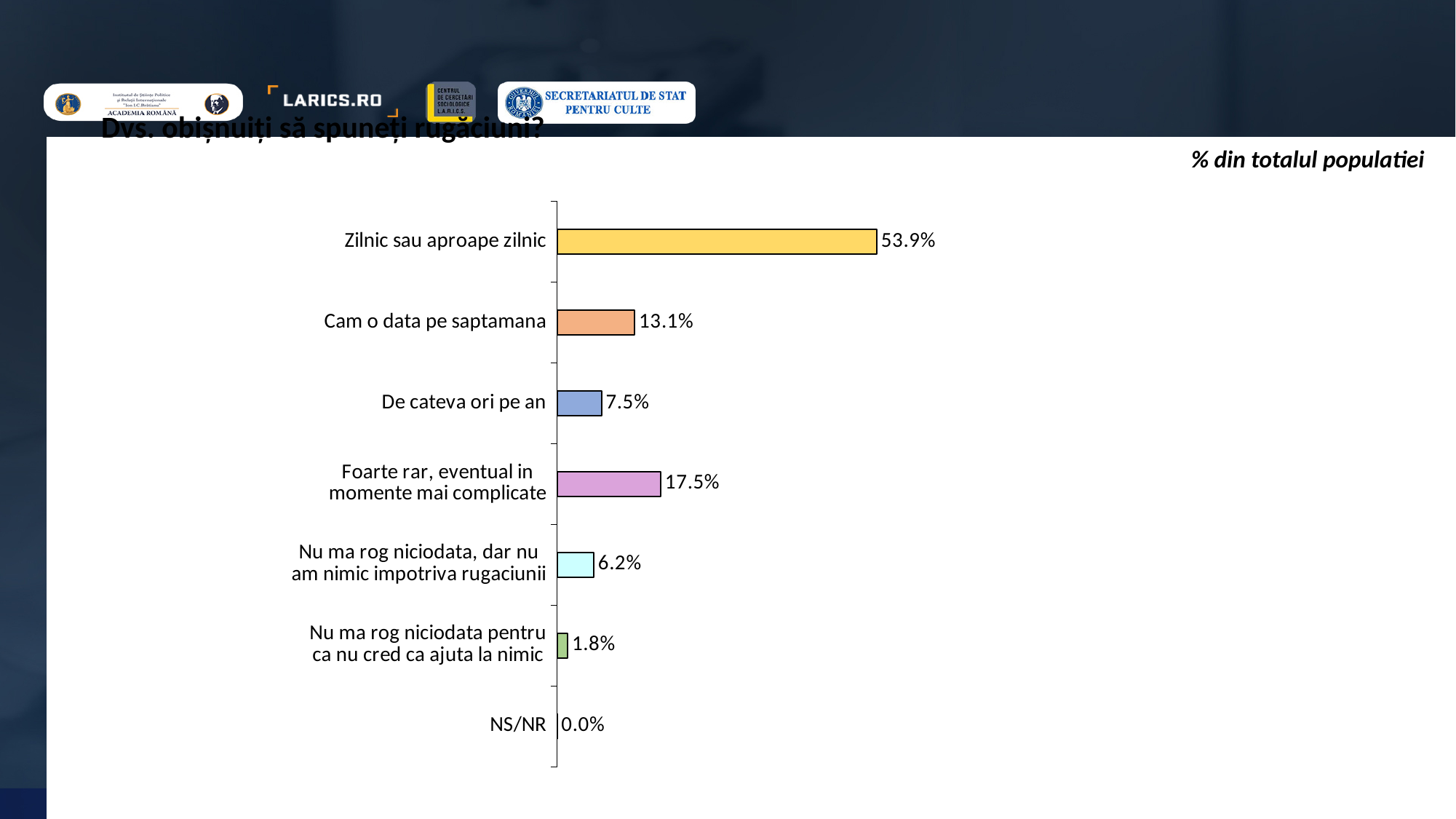
Which category has the lowest value? NS/NR What is the value for "De cateva ori pe an"? 7.5% What is the value for "Nu ma rog niciodata pentru ca nu cred ca ajuta la nimic"? 1.8% What unit note is shown at the top right of the chart? % din totalul populatiei What kind of chart is shown on the slide? Bar chart What is the value for "Foarte rar, eventual in momente mai complicate"? 17.5% What is the value for "Zilnic sau aproape zilnic"? 53.9% How many categories are shown in the chart? 7 Which category has the highest value? Zilnic sau aproape zilnic What is the value for "Cam o data pe saptamana"? 13.1% Which is larger: "Cam o data pe saptamana" or "Foarte rar, eventual in momente mai complicate"? Foarte rar, eventual in momente mai complicate What is the difference between "Zilnic sau aproape zilnic" and "Foarte rar, eventual in momente mai complicate"? 36.4%